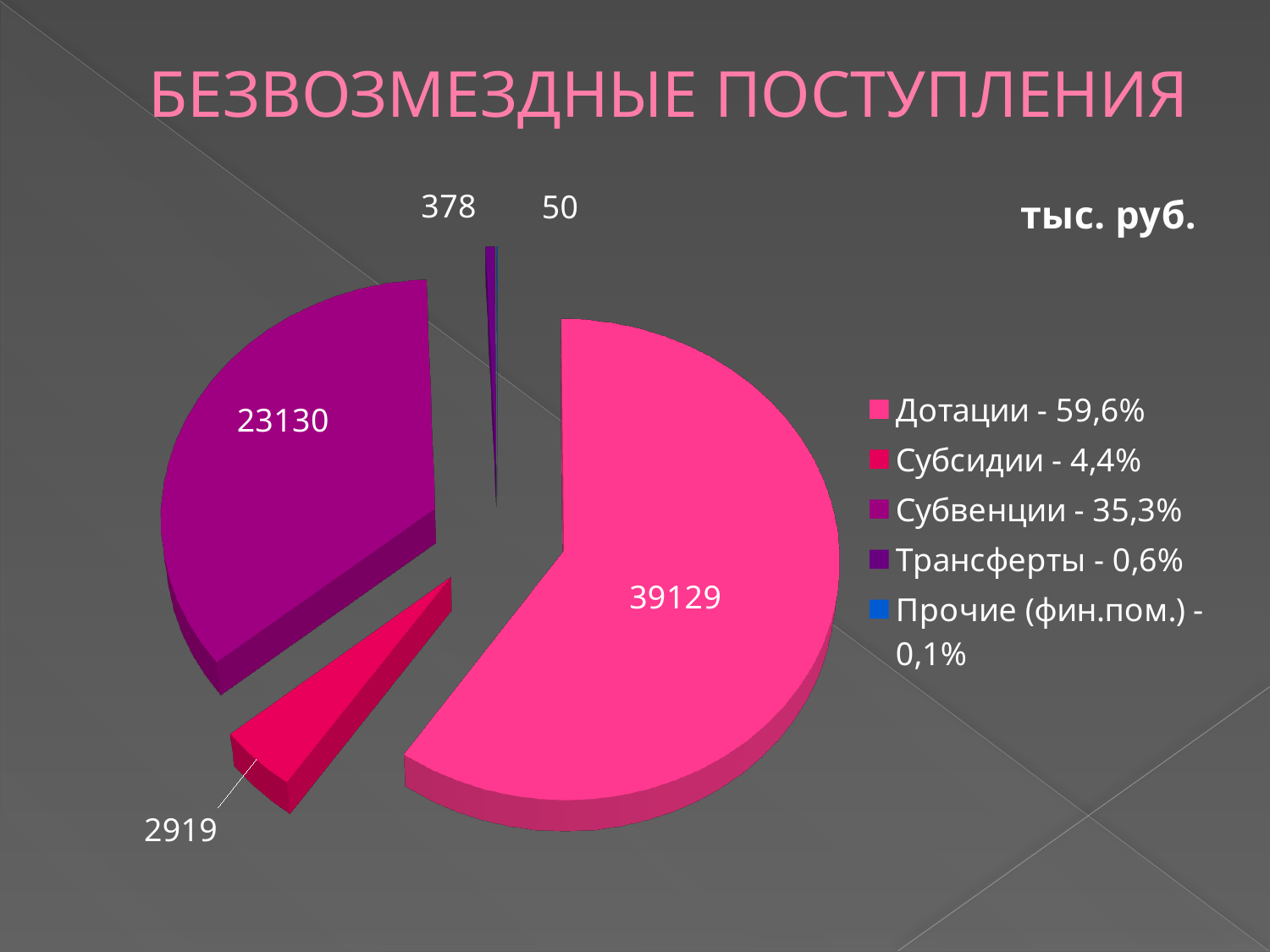
What kind of chart is shown on the slide? pie chart What share of the pie does Субвенции represent, according to the legend? 35,3% What is the value for Дотации? 39129 How many categories does the pie chart show? 5 What is the value for Трансферты? 378 What is the value for Субвенции? 23130 Which category has the smallest slice of the pie? Прочие (фин.пом.) Which category has the largest slice of the pie? Дотации Which is larger, the value for Субсидии or the value for Трансферты? Субсидии What is the difference between the values for Дотации and Субвенции? 15999 What unit is stated for the values on the chart? тыс. руб. What is the value for Субсидии? 2919